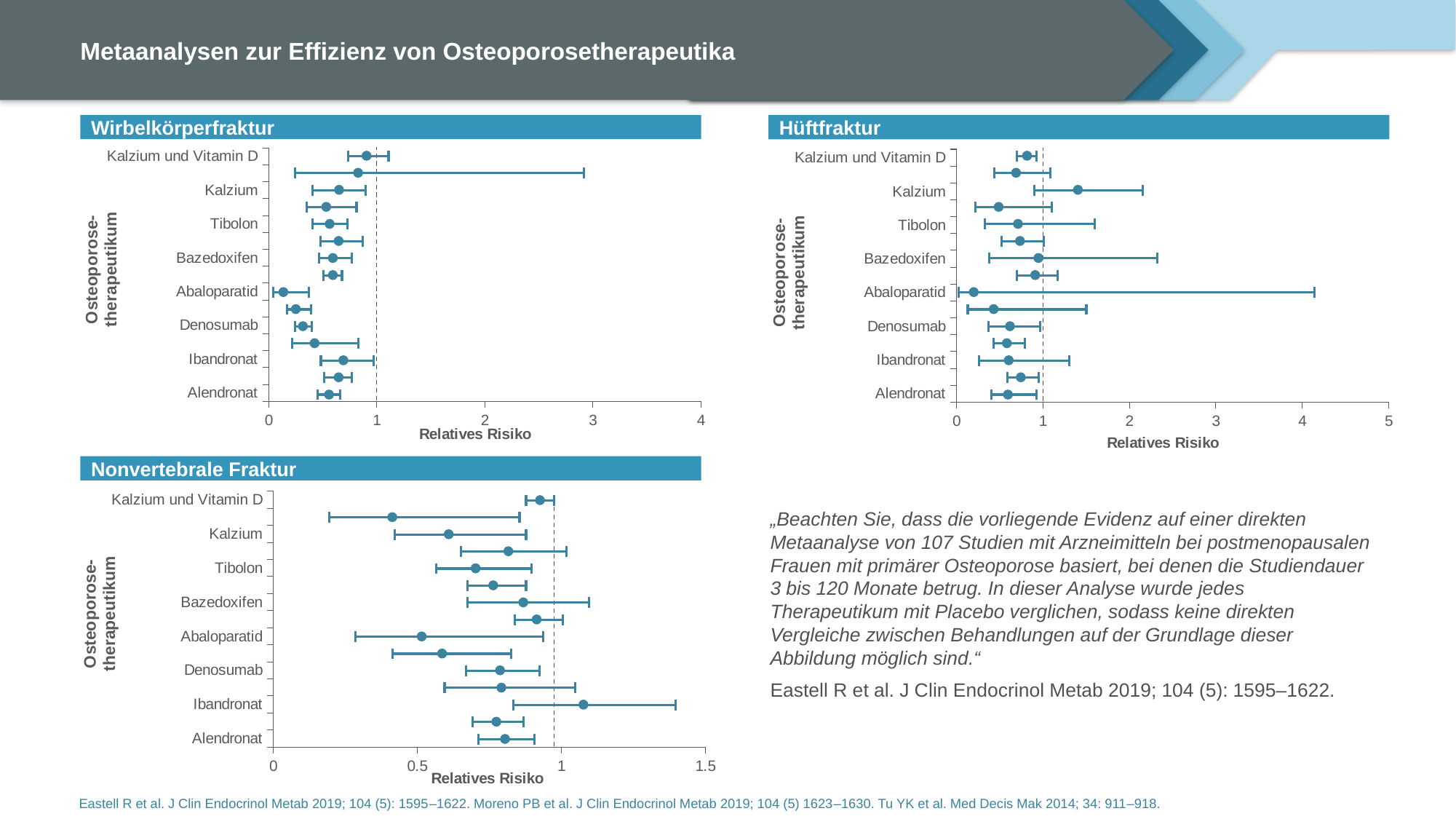
In the Wirbelkörperfraktur chart, are the values for Abaloparatid greater or less than 1? less In the Wirbelkörperfraktur chart, which therapeutic has the lowest plotted relative risk? Abaloparatid In the Nonvertebrale Fraktur chart, is the upper value for Kalzium und Vitamin D greater or less than 1? less What is the highest tick value on the x axis of the Hüftfraktur chart? 5 In the Hüftfraktur chart, is the upper value for Kalzium greater or less than 1? greater What kind of chart is the Hüftfraktur chart? Scatter chart with error bars In the Nonvertebrale Fraktur chart, which therapeutic has the highest plotted relative risk? Ibandronat In the Hüftfraktur chart, which therapeutic has the highest plotted relative risk? Kalzium What is the x-axis title of the Wirbelkörperfraktur chart? Relatives Risiko In the Hüftfraktur chart, which therapeutic has the lowest plotted relative risk? Abaloparatid In the Wirbelkörperfraktur chart, how many therapeutics are listed on the y axis? 8 How many charts are shown on the slide? 3